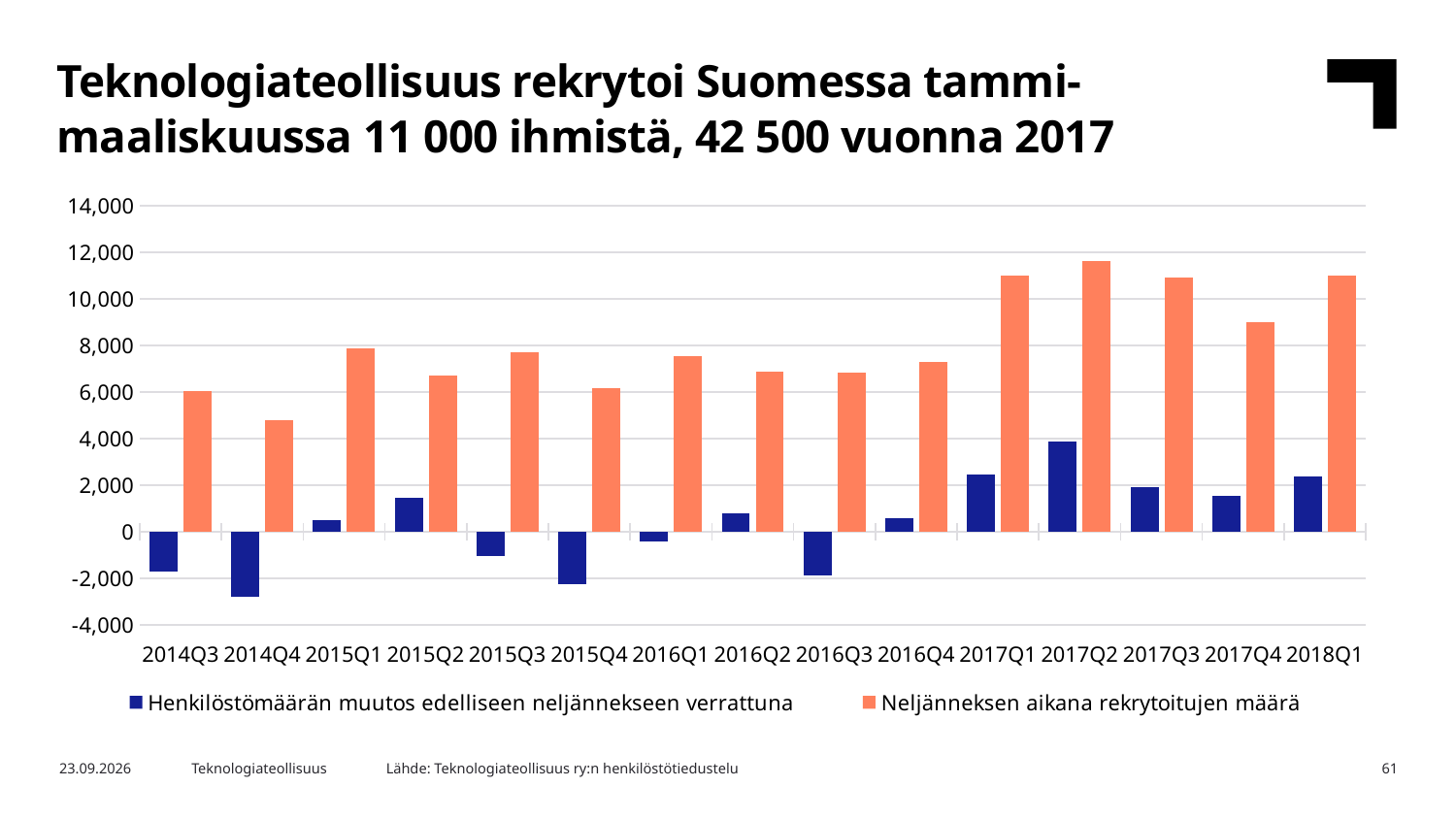
Which quarter has the highest value for Henkilöstömäärän muutos edelliseen neljännekseen verrattuna? 2017Q2 Which is larger, the Neljänneksen aikana rekrytoitujen määrä value for 2017Q1 or for 2017Q4? 2017Q1 Which quarter has the lowest value for Neljänneksen aikana rekrytoitujen määrä? 2014Q4 Is the value for Neljänneksen aikana rekrytoitujen määrä in 2017Q2 greater or less than 10,000? greater Is the value for Neljänneksen aikana rekrytoitujen määrä in 2017Q4 greater or less than 10,000? less How many series does the legend list? 2 Which quarter has the lowest value for Henkilöstömäärän muutos edelliseen neljännekseen verrattuna? 2014Q4 Which series is shown in orange in the legend? Neljänneksen aikana rekrytoitujen määrä Which quarter has the highest value for Neljänneksen aikana rekrytoitujen määrä? 2017Q2 Is the value for Henkilöstömäärän muutos edelliseen neljännekseen verrattuna in 2014Q4 greater or less than -2,000? less How many quarters are shown on the x axis? 15 What kind of chart is shown on the slide? bar chart